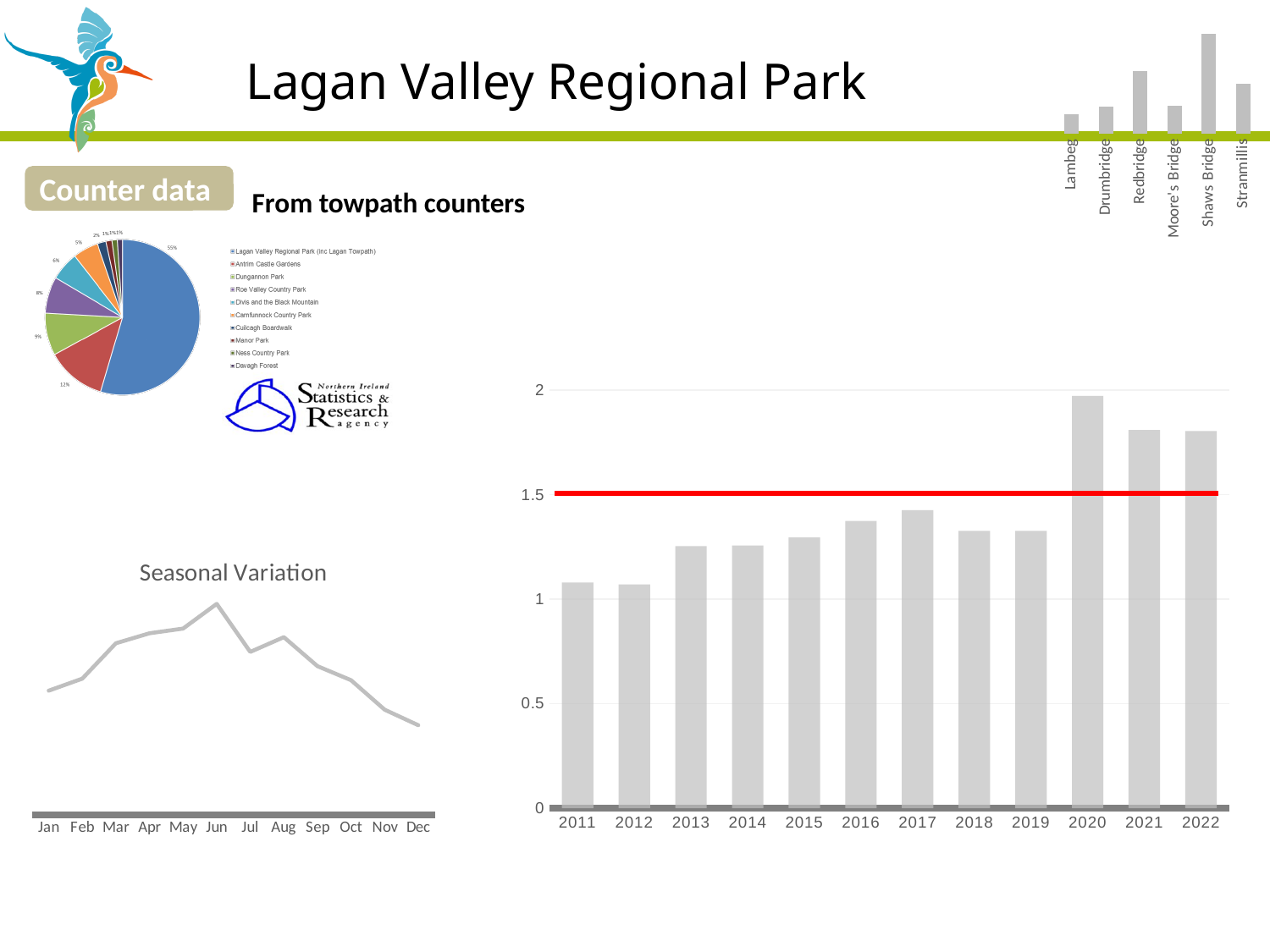
On the Seasonal Variation chart, which month has the lowest value? Dec What kind of chart is the Seasonal Variation chart? line chart On the pie chart at the top left, what share does Lagan Valley Regional Park (inc Lagan Towpath) have? 55% On the large bar chart on the right, how many years are shown on the x axis? 12 On the large bar chart on the right, which is larger, the value for 2017 or the value for 2013? 2017 On the large bar chart on the right, do the values generally rise or fall from 2011 to 2022? rise On the Seasonal Variation chart, which month has the highest value? Jun On the small bar chart at the top right, which location has the highest bar? Shaws Bridge On the large bar chart on the right, is the value for 2011 greater or less than 1? greater On the large bar chart on the right, which year has the highest bar? 2020 On the large bar chart on the right, is the value for 2020 greater or less than 1.5? greater On the large bar chart on the right, is the value for 2018 greater or less than 1.5? less